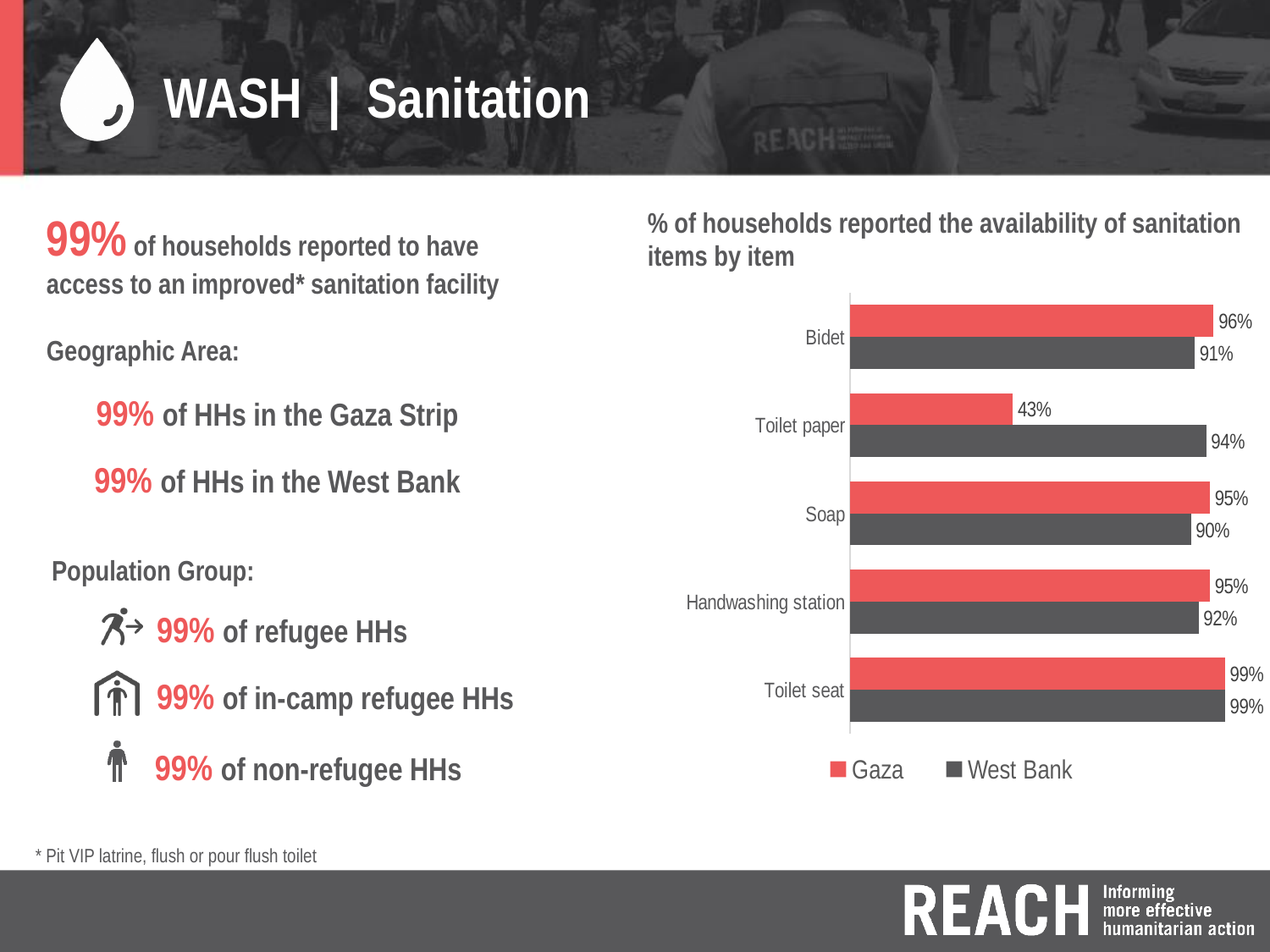
Which colour represents Gaza in the chart? Red How many sanitation items are shown in the chart? 5 For soap, which is larger: the Gaza value or the West Bank value? Gaza Which item has the lowest value for Gaza? Toilet paper What type of chart is used to show the availability of sanitation items? Bar chart What percentage of households in Gaza reported availability of soap? 95% Which item has the highest value for the West Bank? Toilet seat How many series does the chart legend list? 2 What is the difference between the West Bank and Gaza values for toilet paper? 51 percentage points What percentage of households in Gaza reported availability of toilet paper? 43% What percentage of households in the West Bank reported availability of a bidet? 91% What is the difference between the Gaza and West Bank values for handwashing station? 3 percentage points